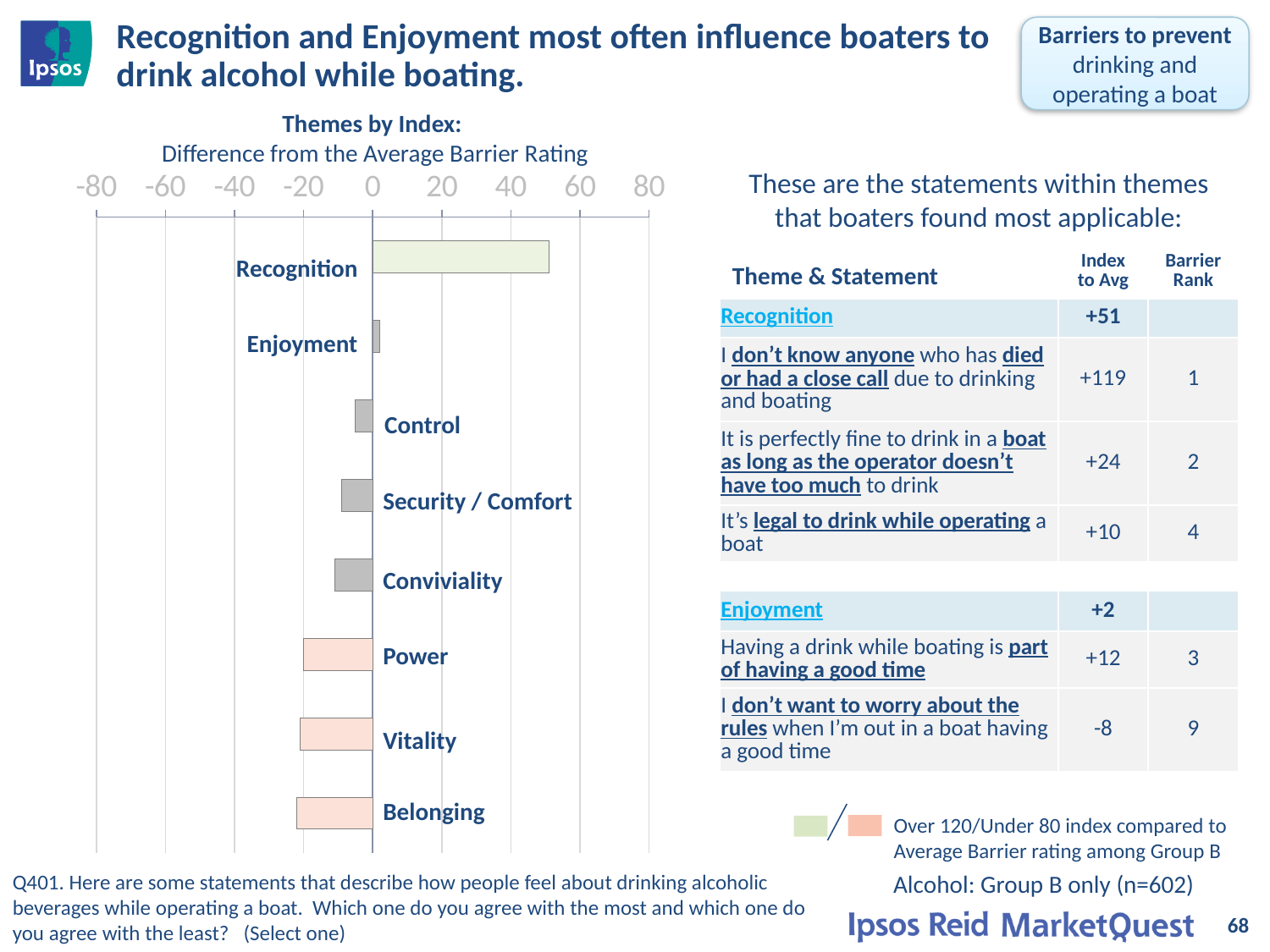
Which has the larger value, Control or Power? Control What is the lowest value shown on the chart's horizontal axis? -80 Is the value for Control greater or less than 0? less What is the title of the bar chart? Themes by Index: Difference from the Average Barrier Rating Which has the larger value, Enjoyment or Conviviality? Enjoyment What kind of chart is shown on the slide? bar chart Is the value for Belonging greater or less than -40? greater Is the value for Recognition greater or less than 40? greater Which theme has the highest value in the bar chart? Recognition How many themes are plotted in the bar chart? 8 Which has the larger value, Recognition or Enjoyment? Recognition